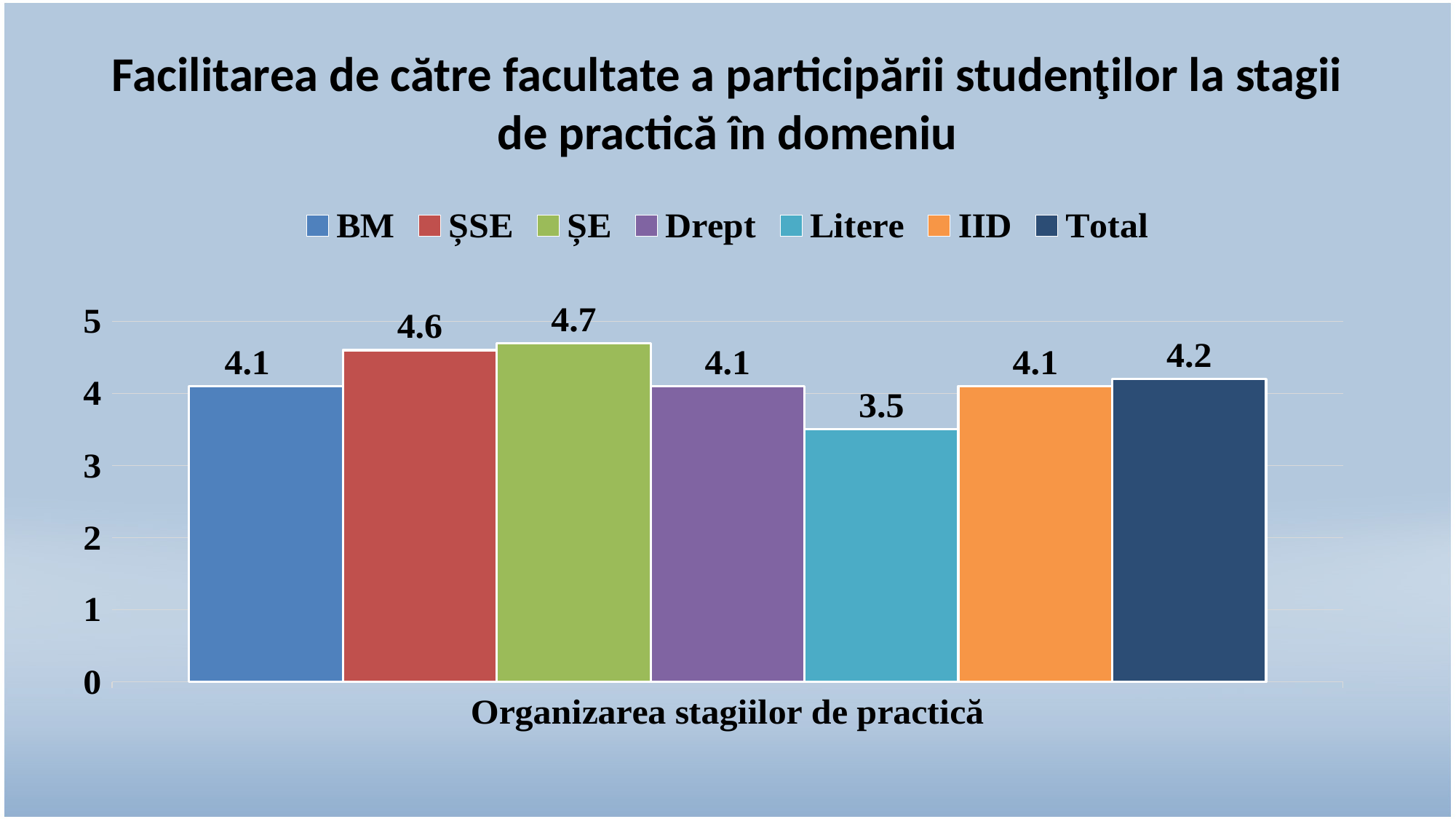
Is the value for Litere greater or less than 4? less What is the value for Litere? 3.5 Which series has the highest value? ȘE What is the value for Total? 4.2 Which is larger, the value for ȘSE or the value for IID? ȘSE Which series has the lowest value? Litere How many series does the legend list? 7 What is the value for Drept? 4.1 What is the value for ȘSE? 4.6 What is the label on the x axis below the bars? Organizarea stagiilor de practică What kind of chart is shown on the slide? bar chart What is the difference between the values for ȘE and Litere? 1.2